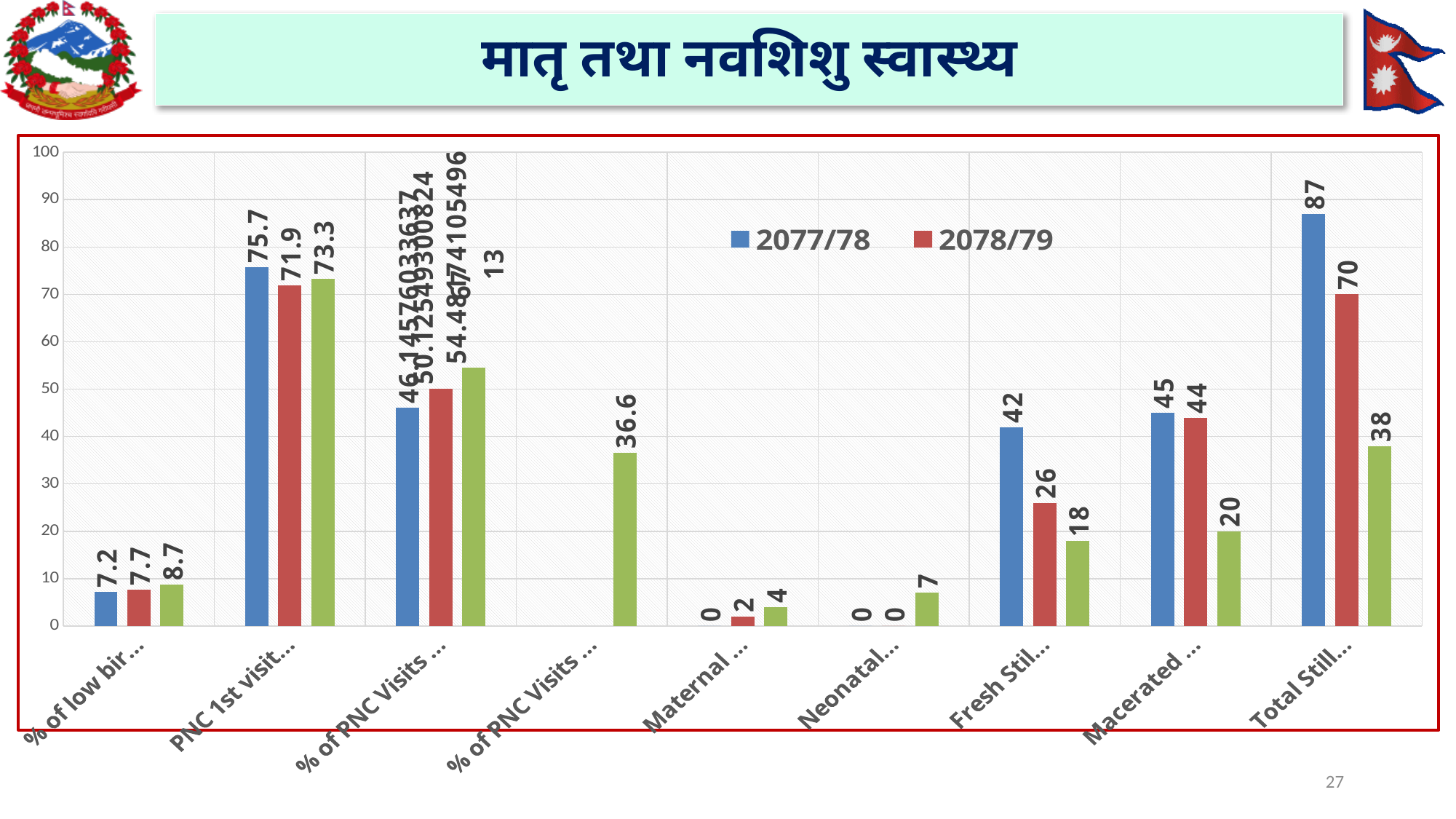
Is the 2078/79 value for the category labelled "Total Still..." greater or less than 60? greater For the category labelled "Fresh Stil...", which is larger: the 2077/78 value or the 2078/79 value? 2077/78 What is the 2078/79 value for the category labelled "Fresh Stil..."? 26 What kind of chart is shown on the slide? bar chart How many series does the legend list? 2 What is the 2077/78 value for the category labelled "PNC 1st visit..."? 75.7 What is the 2078/79 value for the category labelled "Neonatal..."? 0 Which category has the highest 2077/78 value? Total Still... What is the difference between the 2077/78 and 2078/79 values for the category labelled "Total Still..."? 17 What is the 2077/78 value for the category labelled "Total Still..."? 87 What colour represents the 2077/78 series in the legend? blue What is the 2078/79 value for the category labelled "% of low bir..."? 7.7